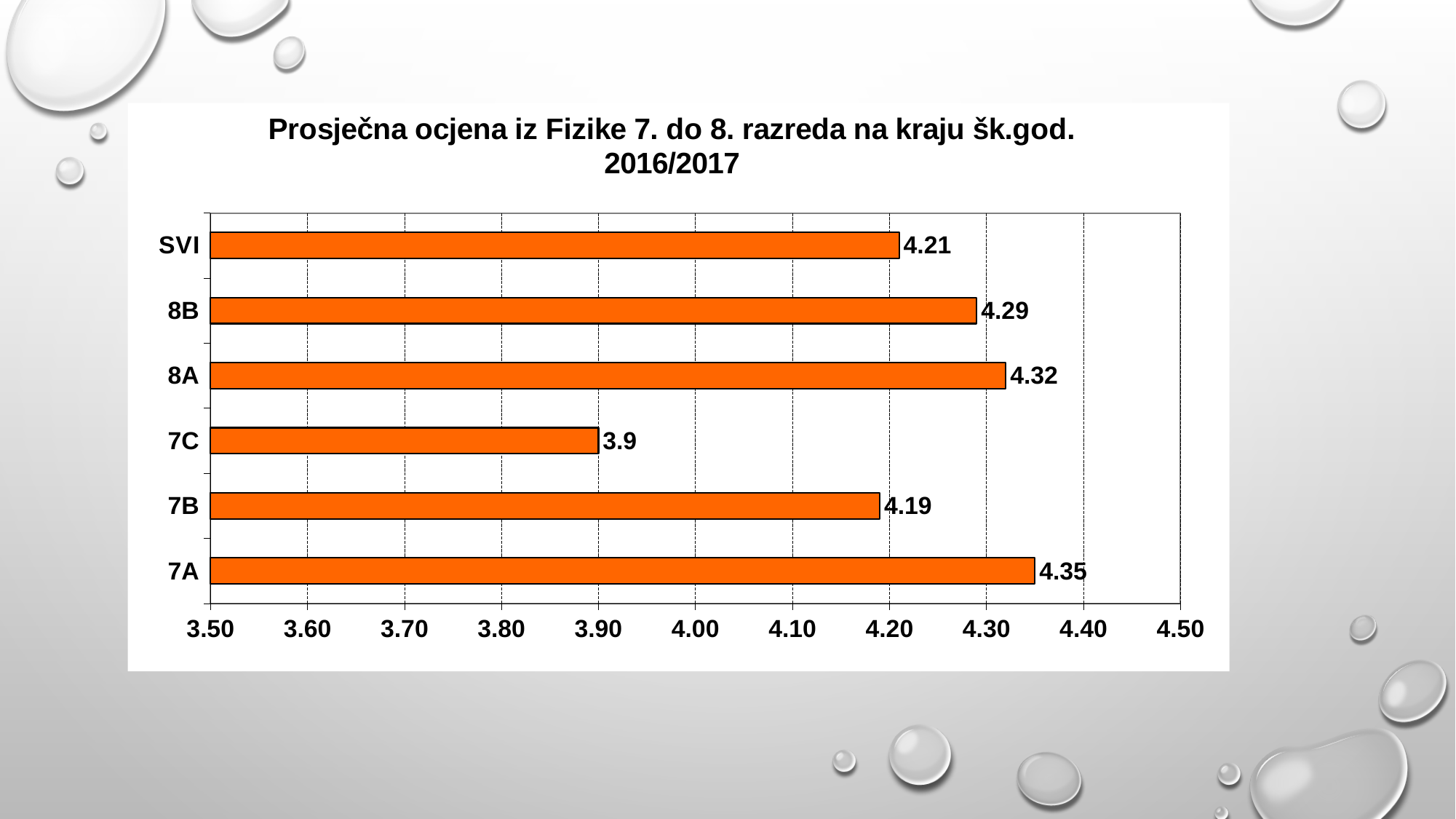
How many categories are shown on the chart? 6 What is the difference between the values for 7A and 7C? 0.45 Which is larger, the value for 7B or the value for 8B? 8B What is the average grade for 7A? 4.35 Which category has the highest value? 7A Which category has the lowest value? 7C Is the value for 7C greater or less than 4.00? less What is the value shown for 7C? 3.9 What colour are the bars in the chart? orange What is the difference between the values for 8A and 8B? 0.03 What is the value shown for SVI? 4.21 What kind of chart is shown on the slide? bar chart